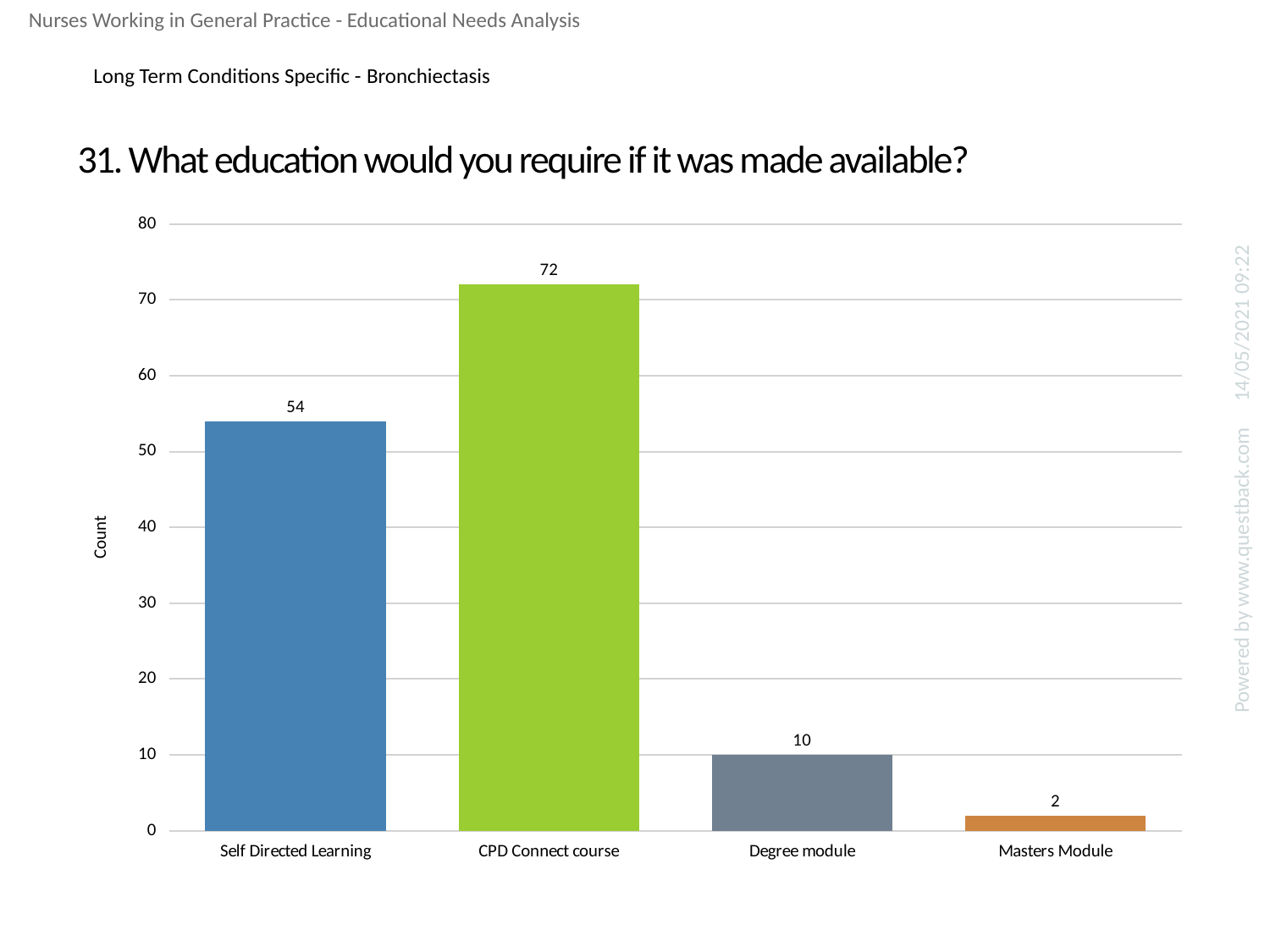
What kind of chart is shown on the slide? Bar chart Which is larger, the count for Self Directed Learning or the count for Degree module? Self Directed Learning What is the label of the y axis? Count Which category has the highest count? CPD Connect course What is the count for Self Directed Learning? 54 What is the count for CPD Connect course? 72 What is the count for Masters Module? 2 How many categories are shown on the x axis? 4 What is the difference between the counts for CPD Connect course and Self Directed Learning? 18 Which category has the lowest count? Masters Module What is the difference between the counts for Degree module and Masters Module? 8 What is the count for Degree module? 10